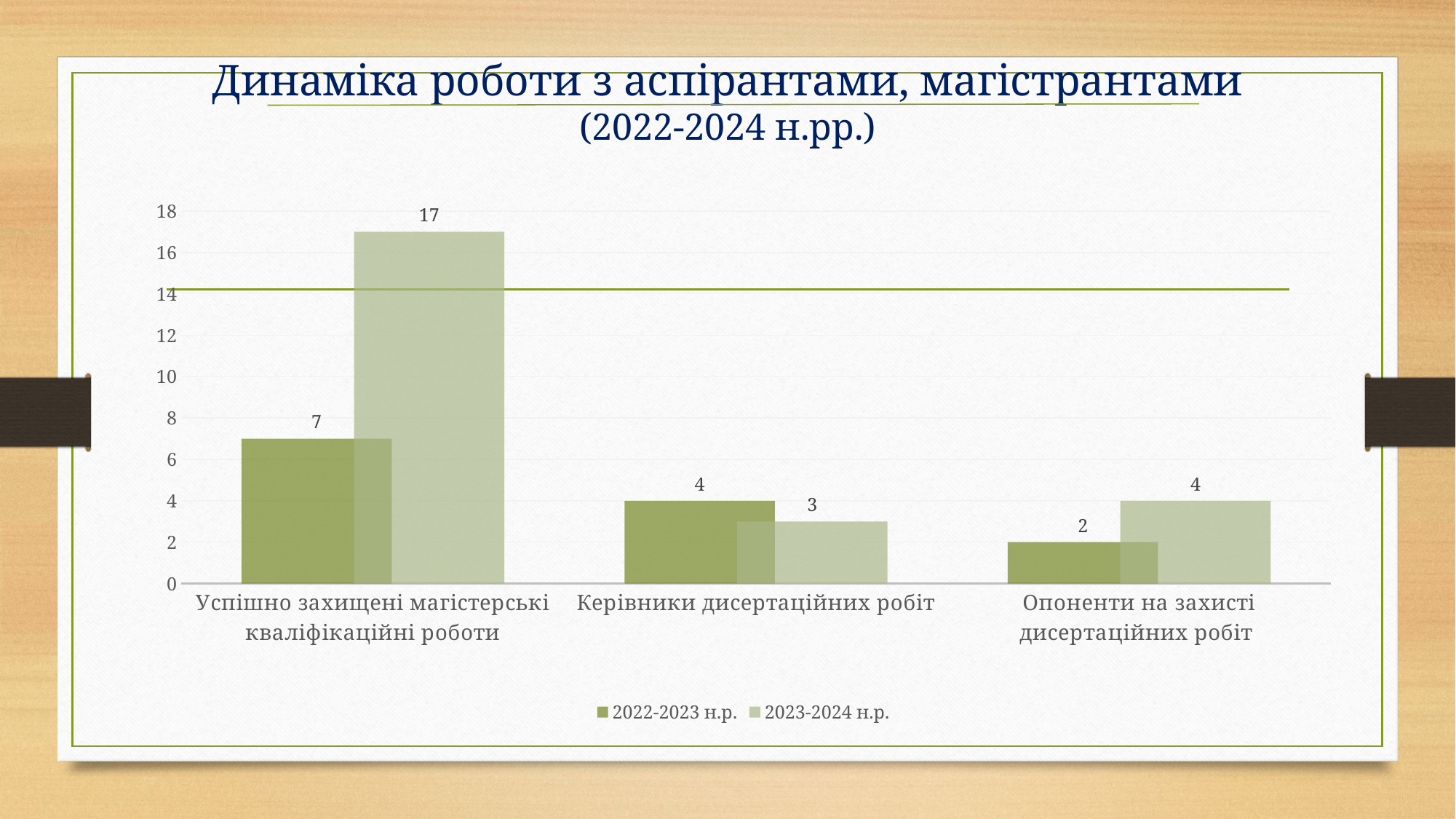
How many categories are shown on the x axis of the chart? 3 What is the value for 2022-2023 н.р. in the category 'Опоненти на захисті дисертаційних робіт'? 2 What is the value for 2023-2024 н.р. in the category 'Керівники дисертаційних робіт'? 3 What is the title of the chart on the slide? Динаміка роботи з аспірантами, магістрантами (2022-2024 н.рр.) What is the difference between the 2023-2024 н.р. and 2022-2023 н.р. values for 'Успішно захищені магістерські кваліфікаційні роботи'? 10 Which category has the highest value for the 2023-2024 н.р. series? Успішно захищені магістерські кваліфікаційні роботи What kind of chart is shown on the slide? Bar chart How many series does the legend list? 2 Which category has the lowest value for the 2022-2023 н.р. series? Опоненти на захисті дисертаційних робіт What is the value for 2022-2023 н.р. in the category 'Успішно захищені магістерські кваліфікаційні роботи'? 7 What is the value for 2023-2024 н.р. in the category 'Успішно захищені магістерські кваліфікаційні роботи'? 17 For 'Керівники дисертаційних робіт', which series has the larger value: 2022-2023 н.р. or 2023-2024 н.р.? 2022-2023 н.р.